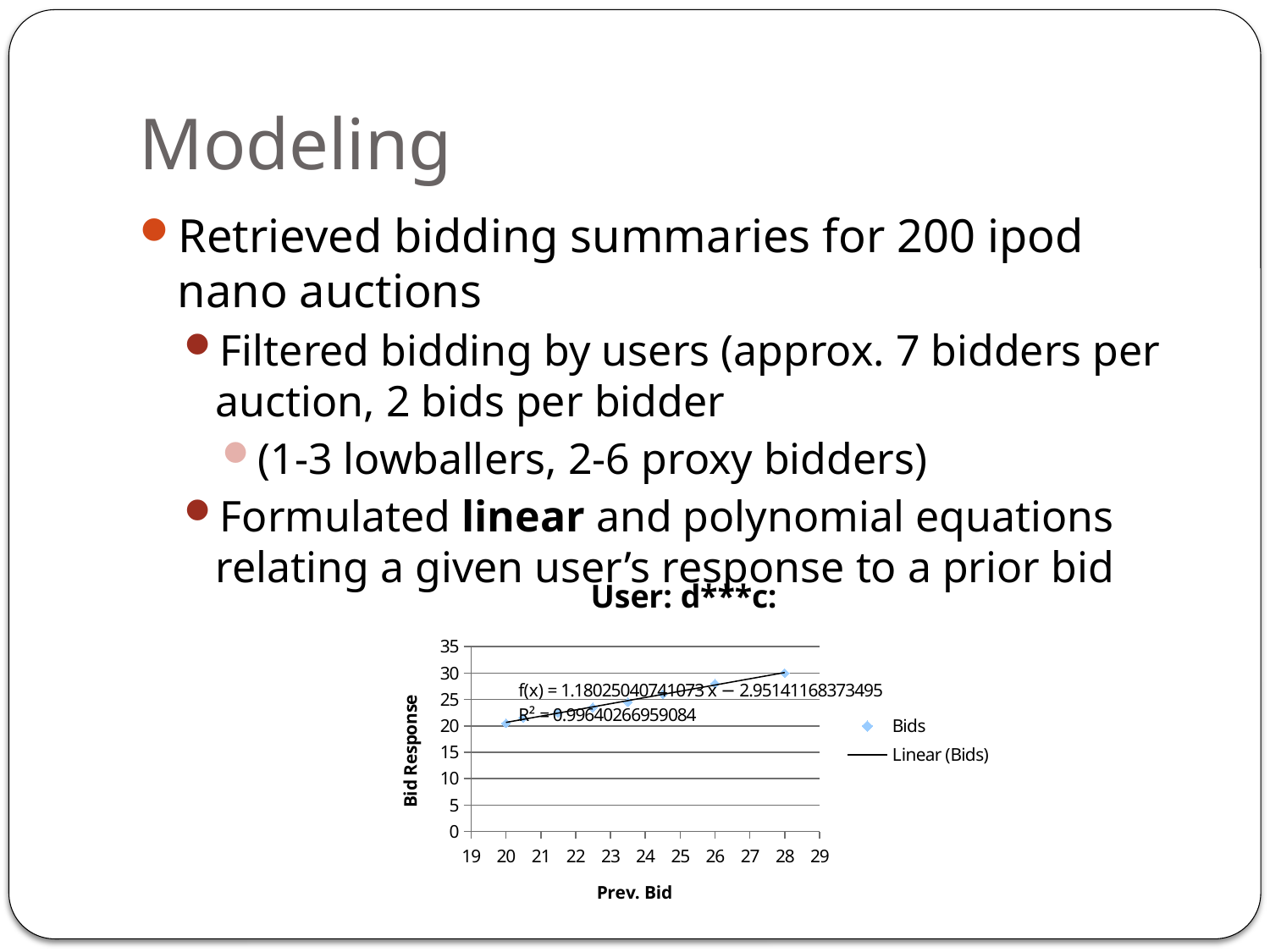
How many data points are plotted for the Bids series? 8 What kind of chart is shown on the slide? scatter chart Is the Bid Response for a Prev. Bid of 20 greater or less than 25? less Which has the larger Bid Response: a Prev. Bid of 20 or a Prev. Bid of 26? 26 What is the label of the x axis? Prev. Bid Is the Bid Response for a Prev. Bid of 26 greater or less than 30? less Is the Bid Response for a Prev. Bid of 28 greater or less than 25? greater Do the Bid Response values rise or fall as Prev. Bid increases? rise What is the title of the chart? User: d***c: How many entries does the chart's legend list? 2 Which Prev. Bid value has the lowest Bid Response? 20 Which Prev. Bid value has the highest Bid Response? 28